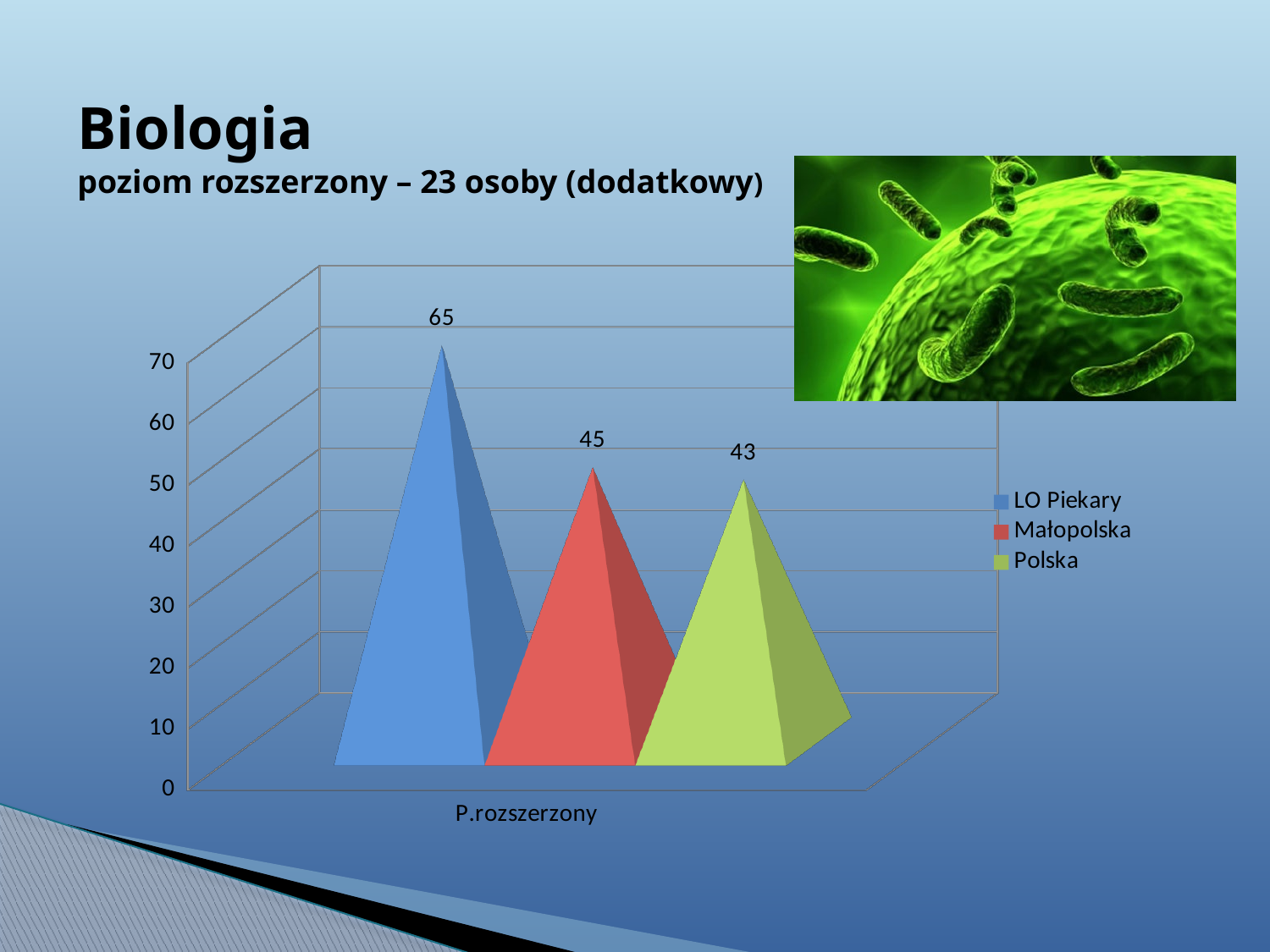
Which series has the lowest value in the P.rozszerzony category? Polska What kind of chart is shown on the slide? bar chart Which is larger, the value for LO Piekary or the value for Polska? LO Piekary What is the category label shown on the x axis of the chart? P.rozszerzony What is the value for LO Piekary in the P.rozszerzony category? 65 What is the difference between the LO Piekary value and the Polska value? 22 Which series has the highest value in the P.rozszerzony category? LO Piekary What is the difference between the LO Piekary value and the Małopolska value? 20 What is the value for Małopolska in the P.rozszerzony category? 45 What is the value for Polska in the P.rozszerzony category? 43 How many series does the legend list? 3 Is the value for LO Piekary greater or less than 60? greater